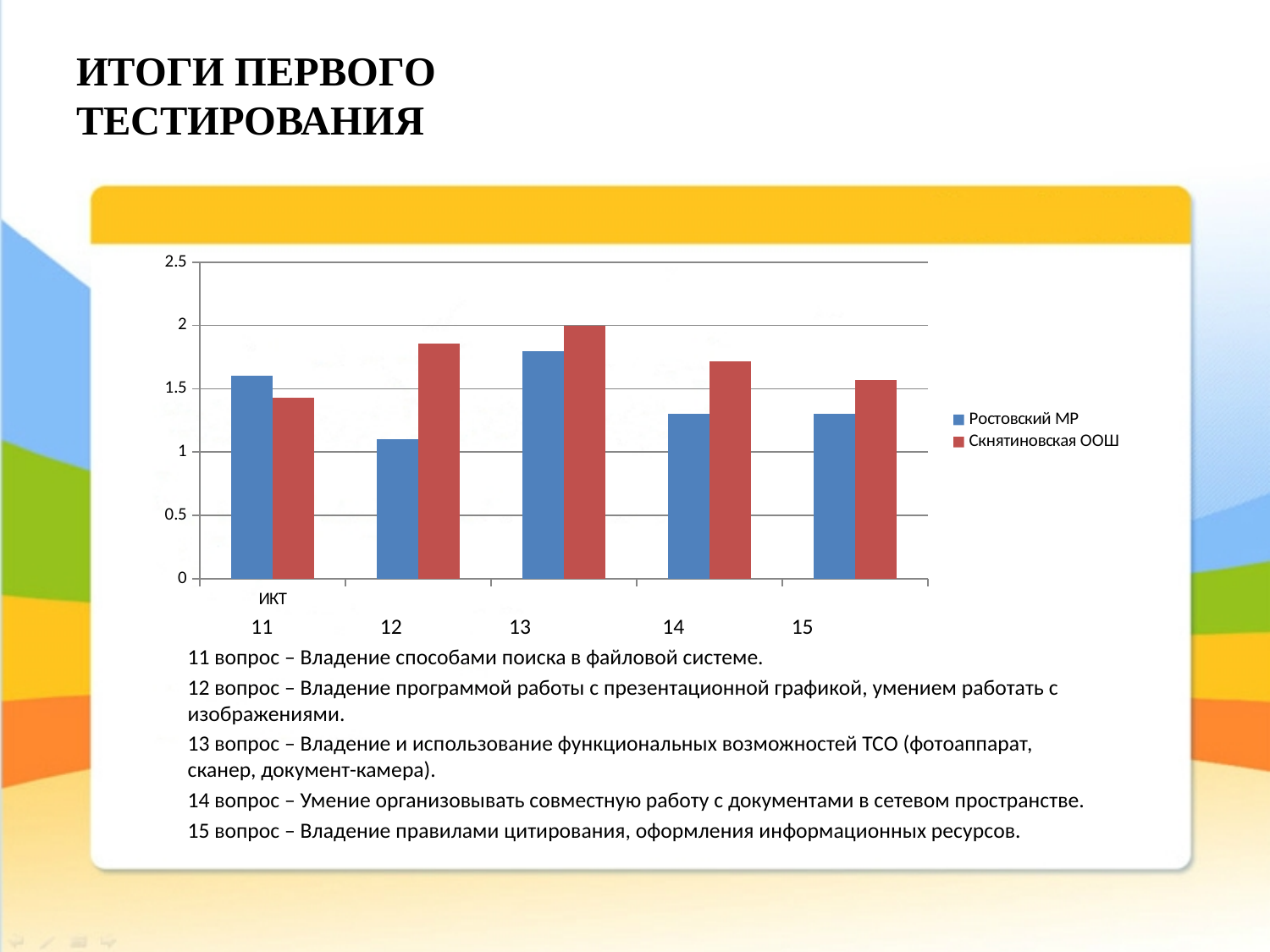
How many series does the legend list? 2 For which category is the value for Скнятиновская ООШ the highest? 13 For category 11, which series has the larger value? Ростовский МР For category 12, which series has the larger value? Скнятиновская ООШ For which category is the value for Ростовский МР the lowest? 12 What kind of chart is shown on the slide? bar chart Is the value for Скнятиновская ООШ in category 12 greater or less than 1.5? greater Is the value for Ростовский МР in category 13 greater or less than 1.5? greater How many categories are shown along the x axis? 5 Which series are listed in the legend? Ростовский МР and Скнятиновская ООШ Is the value for Ростовский МР in category 12 greater or less than 1.5? less For which category is the value for Ростовский МР the highest? 13